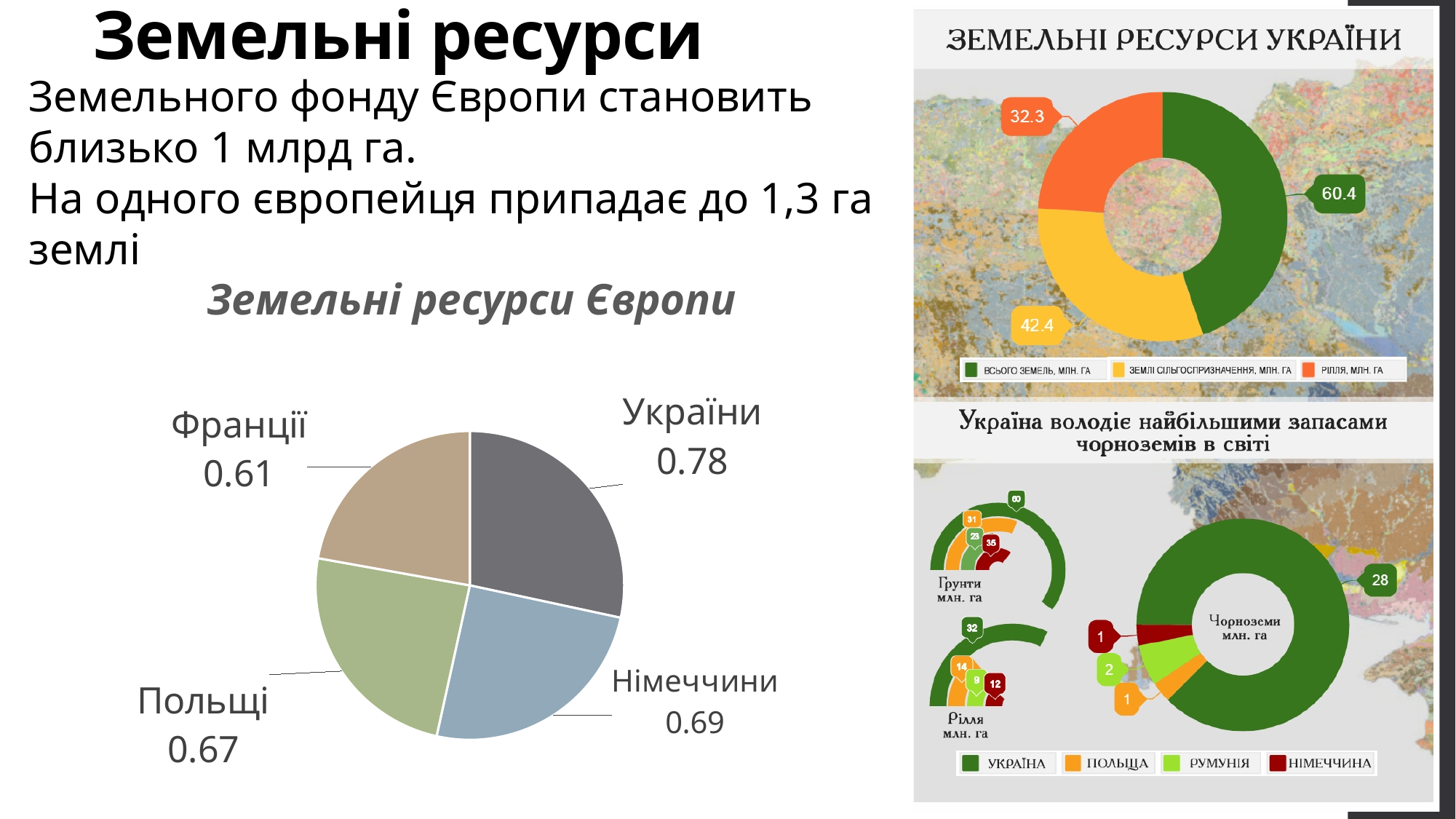
In the pie chart 'Земельні ресурси Європи', what is the value for Польщі? 0.67 What type of chart is 'Земельні ресурси Європи'? Pie chart In the pie chart 'Земельні ресурси Європи', which category has the highest value? України In the pie chart 'Земельні ресурси Європи', which category has the lowest value? Франції In the donut chart 'Земельні ресурси України' on the right, what value is shown for Рілля, млн. га? 32.3 In the pie chart 'Земельні ресурси Європи', which is larger, the value for Німеччини or the value for Польщі? Німеччини In the pie chart 'Земельні ресурси Європи', what is the value for Франції? 0.61 In the donut chart 'Земельні ресурси України' on the right, what value is shown for Всього земель, млн. га? 60.4 In the pie chart 'Земельні ресурси Європи', what is the difference between the values for України and Франції? 0.17 In the pie chart 'Земельні ресурси Європи', what is the value for України? 0.78 How many entries does the legend of the donut chart 'Земельні ресурси України' list? 3 How many categories does the pie chart 'Земельні ресурси Європи' show? 4